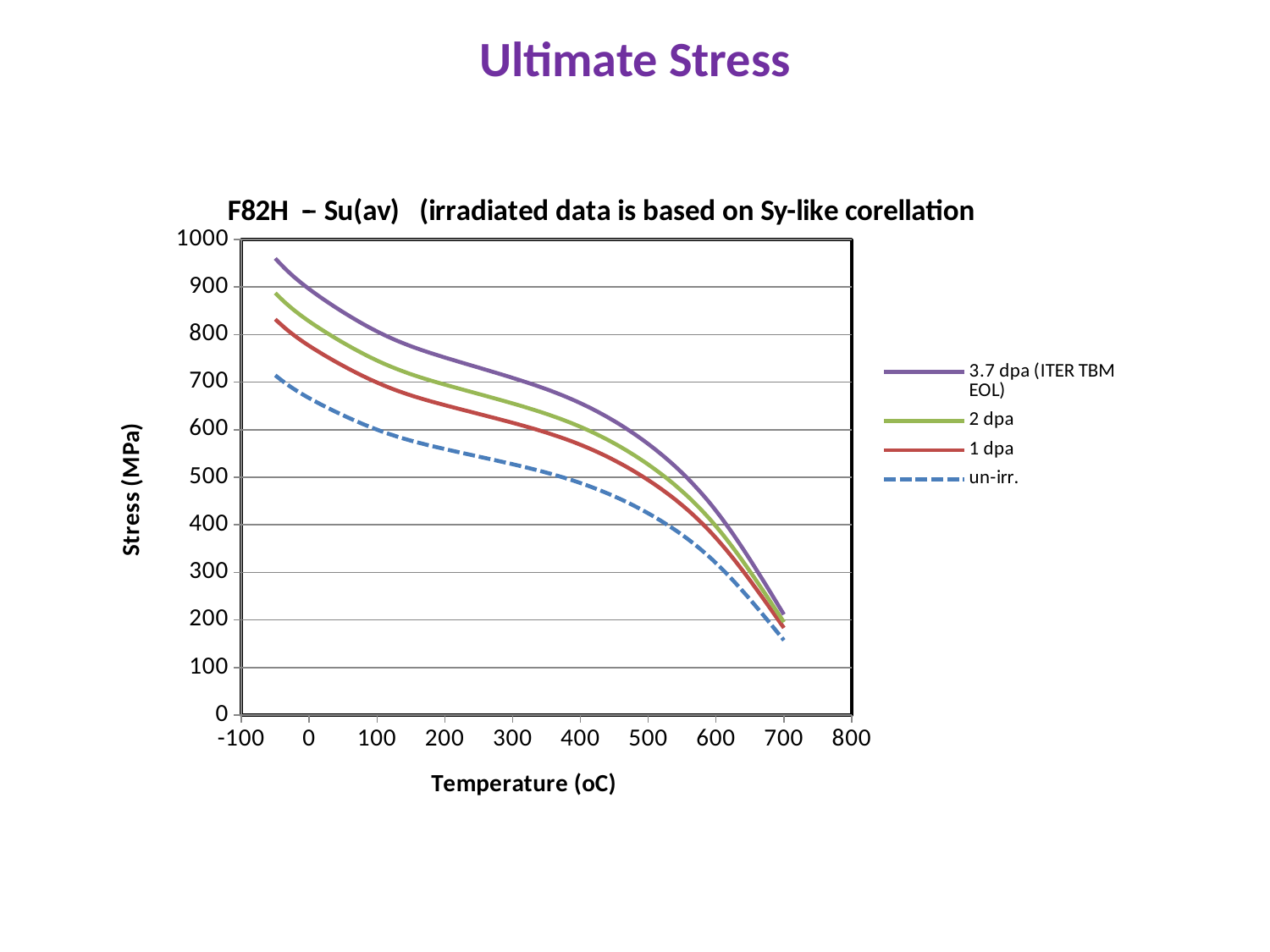
At 300 °C, which series has the larger stress: 3.7 dpa (ITER TBM EOL) or un-irr.? 3.7 dpa (ITER TBM EOL) How many series does the legend list? 4 Which series is drawn with a dashed line? un-irr. Is the stress for the un-irr. series at 0 °C greater or less than 600 MPa? greater What kind of chart is shown on the slide? line chart Which series has the lowest stress values across the temperature range? un-irr. Is the stress for the 3.7 dpa (ITER TBM EOL) series at 0 °C greater or less than 800 MPa? greater Is the stress for the un-irr. series at 700 °C greater or less than 200 MPa? less What is the label of the y axis? Stress (MPa) Which series has the highest stress values across the temperature range? 3.7 dpa (ITER TBM EOL) Do the stress values rise or fall as temperature increases along the x axis? fall